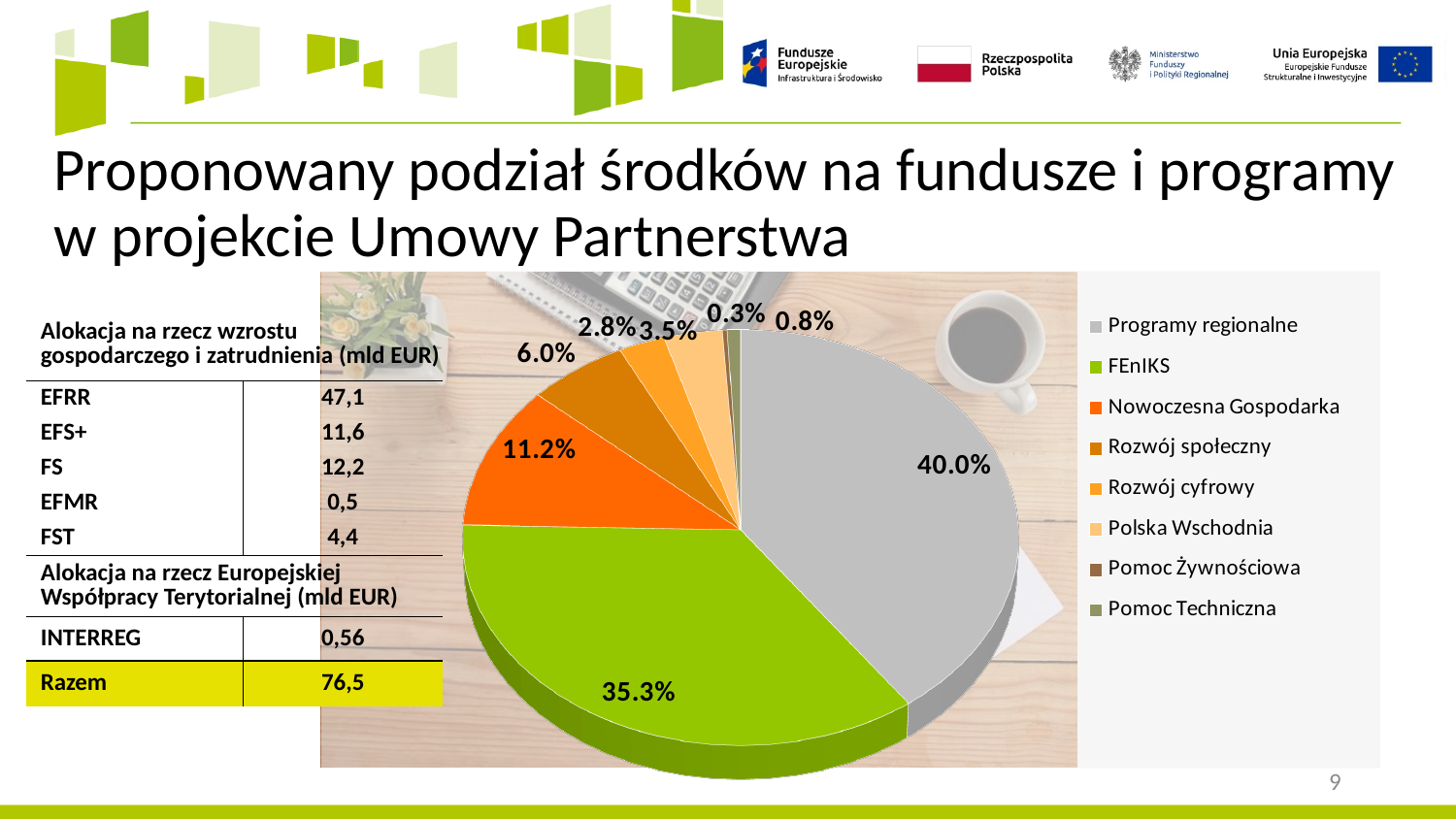
Which category has the smallest slice of the pie? Pomoc Żywnościowa What share of the pie does Rozwój społeczny have? 6.0% Which category has the largest slice of the pie? Programy regionalne What share of the pie does Polska Wschodnia have? 3.5% Which is larger, the slice for Rozwój cyfrowy or the slice for Polska Wschodnia? Polska Wschodnia What is the difference in percentage points between Programy regionalne and FEnIKS? 4.7 What share of the pie does FEnIKS have? 35.3% What share of the pie does Nowoczesna Gospodarka have? 11.2% What kind of chart is shown on the slide? pie chart What share of the pie does Programy regionalne have? 40.0% What colour is the FEnIKS slice in the pie chart? green How many categories does the pie chart legend list? 8